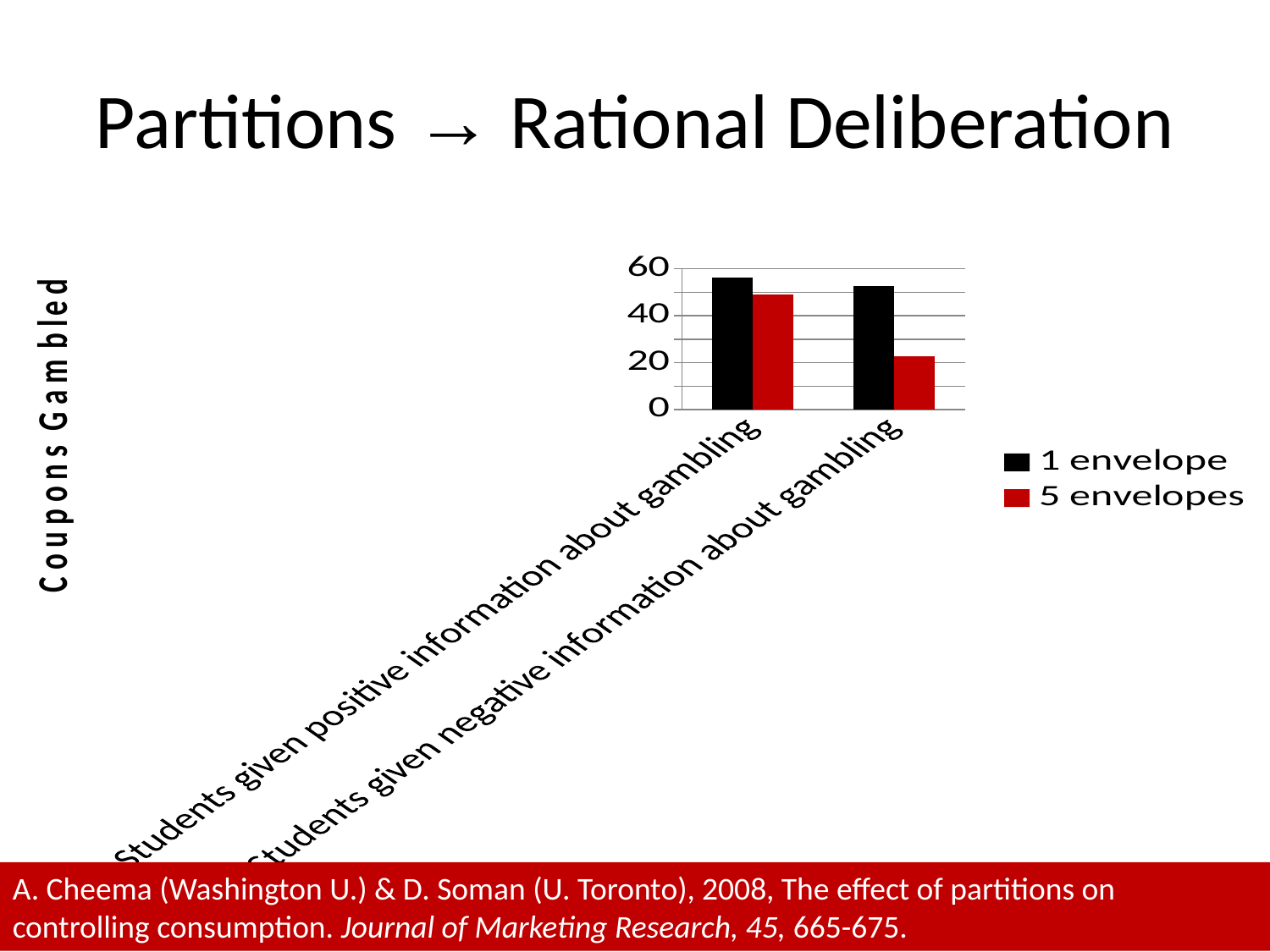
How many categories are shown on the x axis of the chart? 2 Is the value for 1 envelope among students given negative information about gambling greater or less than 40? greater What kind of chart is shown on the slide? bar chart How many series does the chart's legend list? 2 Which bar in the chart is the lowest? 5 envelopes, students given negative information about gambling Is the value for 5 envelopes among students given negative information about gambling greater or less than 40? less Is the value for 1 envelope among students given positive information about gambling greater or less than 40? greater For the 5 envelopes series, which category has the lower value? Students given negative information about gambling What is the label of the vertical axis of the chart? Coupons Gambled For students given negative information about gambling, which is larger: the value for 1 envelope or for 5 envelopes? 1 envelope Which series is shown in red in the chart? 5 envelopes